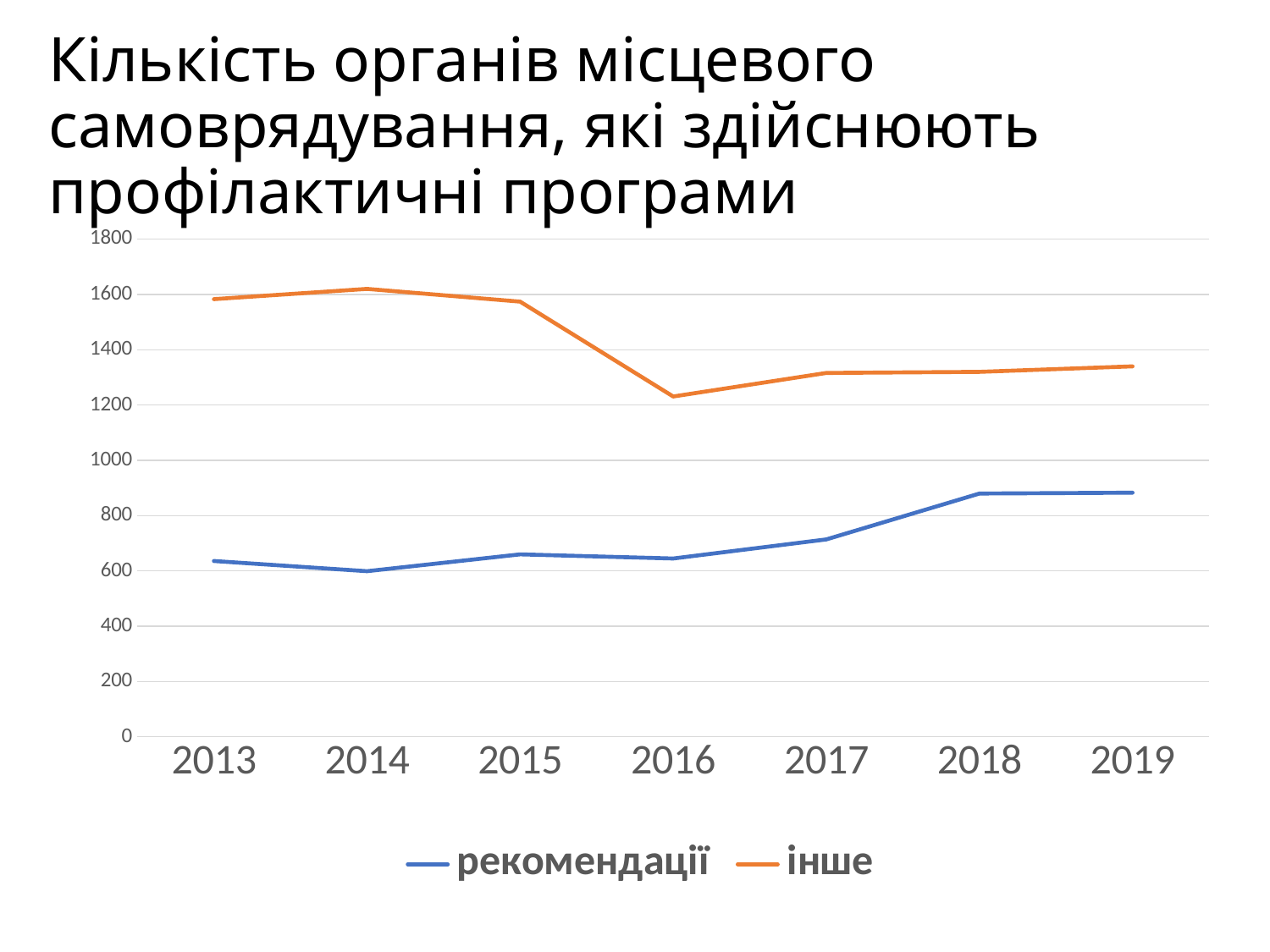
Is the value for рекомендації in 2014 greater or less than 800? less What kind of chart is shown on the slide? line chart How many years are plotted along the x axis? 7 In which year is the value for інше lowest? 2016 Does the value for інше rise or fall from 2014 to 2016? fall Which series is drawn in orange? інше Which series has the larger value in 2016, рекомендації or інше? інше Does the value for рекомендації rise or fall from 2016 to 2018? rise How many series does the legend list? 2 Is the value for рекомендації in 2018 greater or less than 800? greater In which year is the value for рекомендації lowest? 2014